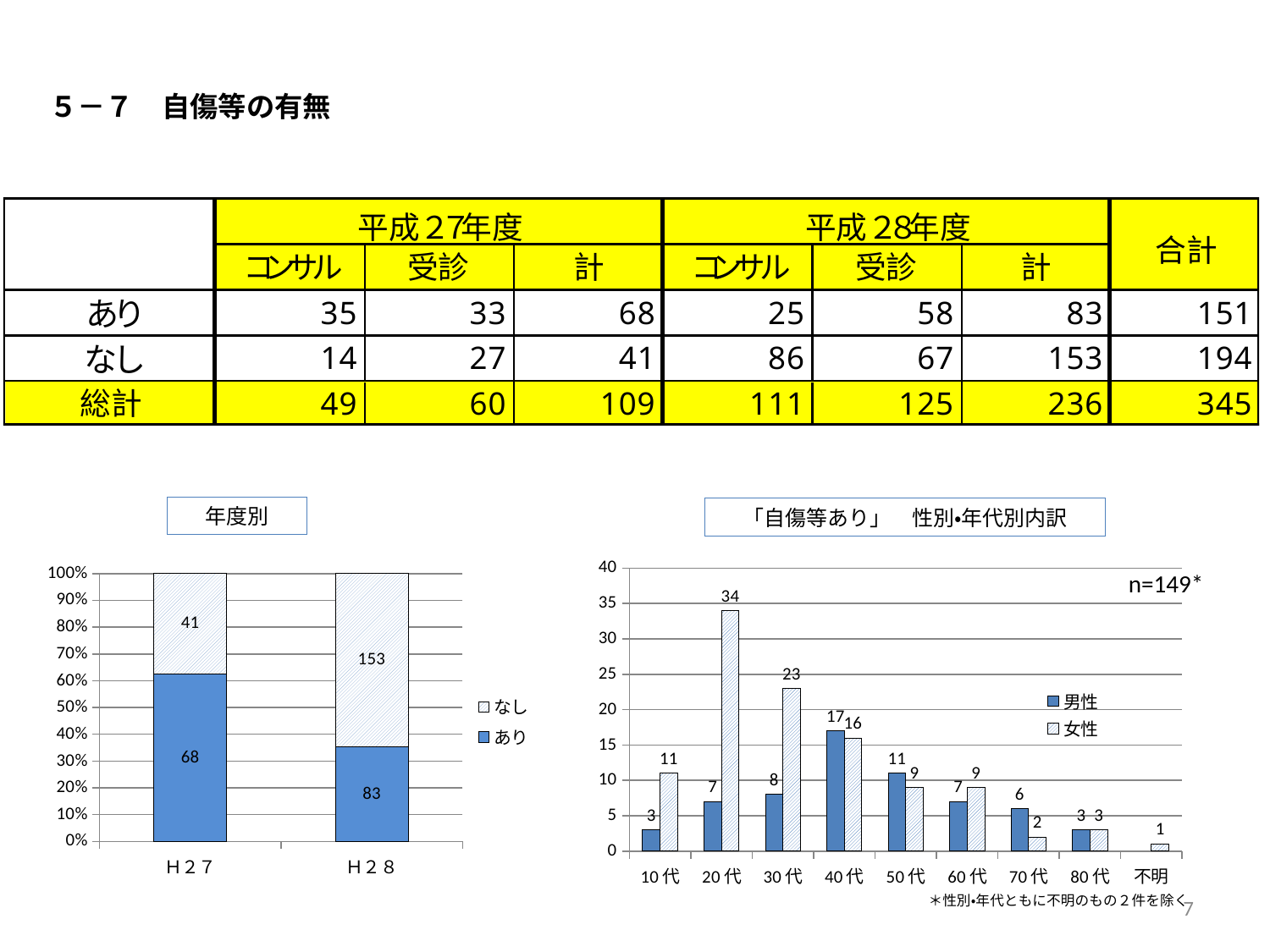
In the 年度別 chart, what is the value of あり for H２７? 68 In the 「自傷等あり」 性別•年代別内訳 chart, how many age categories are shown on the x axis? 9 In the 「自傷等あり」 性別•年代別内訳 chart, which age group has the highest 男性 value? 40代 In the 年度別 chart, what is the total of the H２８ bar (あり plus なし)? 236 In the 年度別 chart, what is the value of なし for H２８? 153 In the 「自傷等あり」 性別•年代別内訳 chart, which is larger in 70代, 男性 or 女性? 男性 In the 「自傷等あり」 性別•年代別内訳 chart, what sample size (n) is shown? n=149* In the 「自傷等あり」 性別•年代別内訳 chart, what is the value for 女性 in 20代? 34 In the 「自傷等あり」 性別•年代別内訳 chart, what is the difference between 女性 and 男性 in 30代? 15 In the 年度別 chart, what kind of chart is shown? stacked bar chart In the 「自傷等あり」 性別•年代別内訳 chart, what is the value for 男性 in 50代? 11 In the 年度別 chart, how many series does the legend list? 2